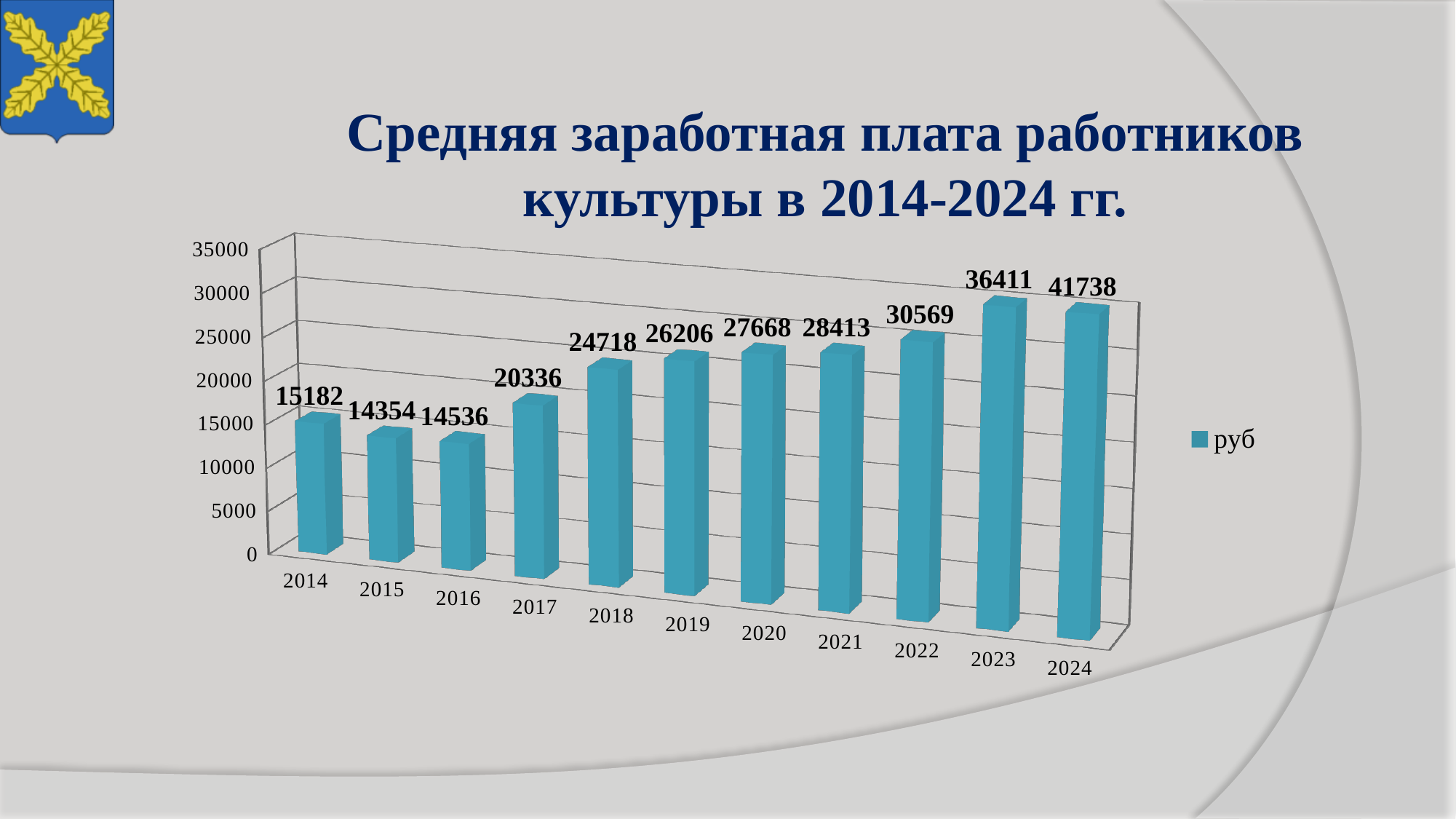
How many series does the legend list? 1 How many years are shown on the x axis? 11 What is the value for 2014? 15182 Which year has the lowest value? 2015 What is the value for 2023? 36411 What is the difference between the values for 2024 and 2014? 26556 What kind of chart is shown? bar chart What is the legend entry for the series? руб Which is larger, the value for 2017 or the value for 2016? 2017 What is the difference between the values for 2023 and 2022? 5842 What is the value for 2019? 26206 Which year has the highest value? 2024